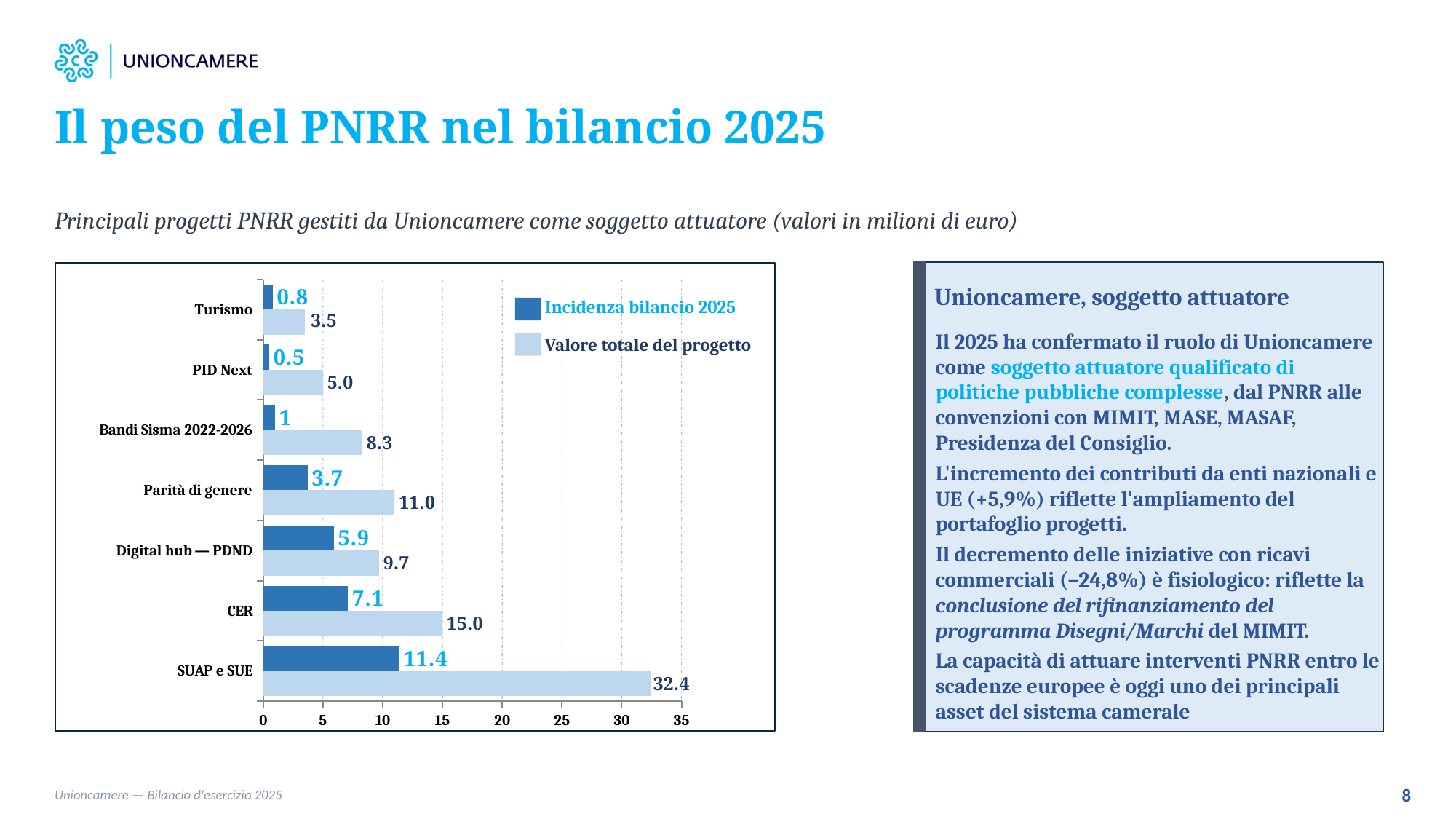
What is the value of "Incidenza bilancio 2025" for SUAP e SUE? 11.4 Which category has the lowest "Incidenza bilancio 2025"? PID Next What is the difference between the "Valore totale del progetto" and the "Incidenza bilancio 2025" for Parità di genere? 7.3 What kind of chart is shown on the slide? Bar chart How many series does the legend list? 2 What is the "Valore totale del progetto" for CER? 15.0 What are the two series named in the chart legend? Incidenza bilancio 2025 and Valore totale del progetto Which is larger: the "Incidenza bilancio 2025" for Digital hub — PDND or for CER? CER How many project categories are shown on the chart? 7 What is the "Valore totale del progetto" for Bandi Sisma 2022-2026? 8.3 Is the "Valore totale del progetto" for SUAP e SUE greater or less than 30? greater Which category has the highest "Valore totale del progetto"? SUAP e SUE